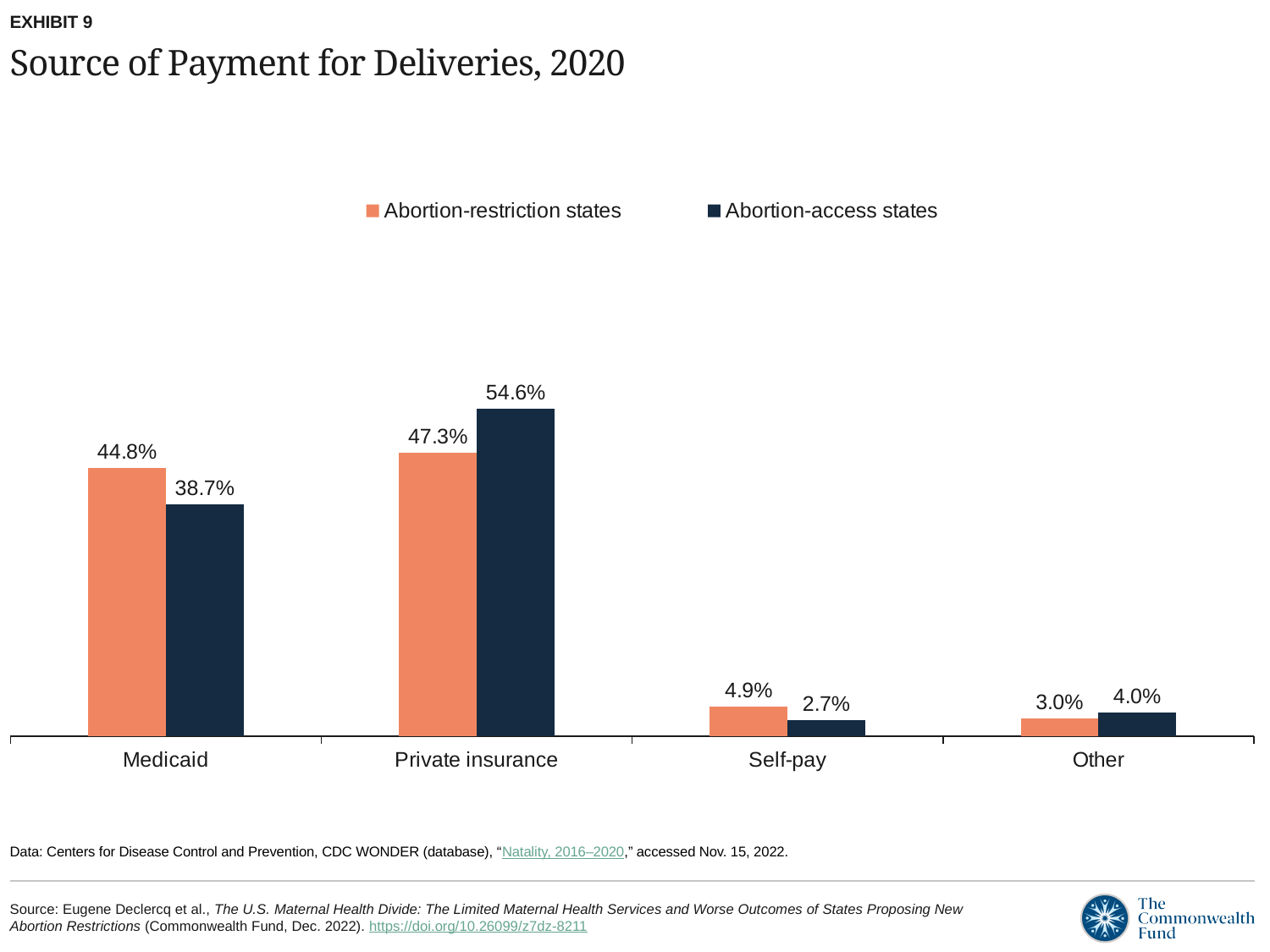
What is the value for Self-pay in abortion-access states? 2.7% Which payment source has the lowest value for abortion-restriction states? Other What is the value for Private insurance in abortion-access states? 54.6% What is the value for Other in abortion-restriction states? 3.0% What is the value for Medicaid in abortion-restriction states? 44.8% What type of chart is shown on the slide? Bar chart How many series does the legend list? 2 Which payment source has the highest value for abortion-access states? Private insurance How many payment source categories are shown on the x axis? 4 What is the difference between abortion-access states and abortion-restriction states for Private insurance? 7.3 percentage points For Self-pay, which is larger: abortion-restriction states or abortion-access states? Abortion-restriction states What is the difference between abortion-restriction states and abortion-access states for Medicaid? 6.1 percentage points